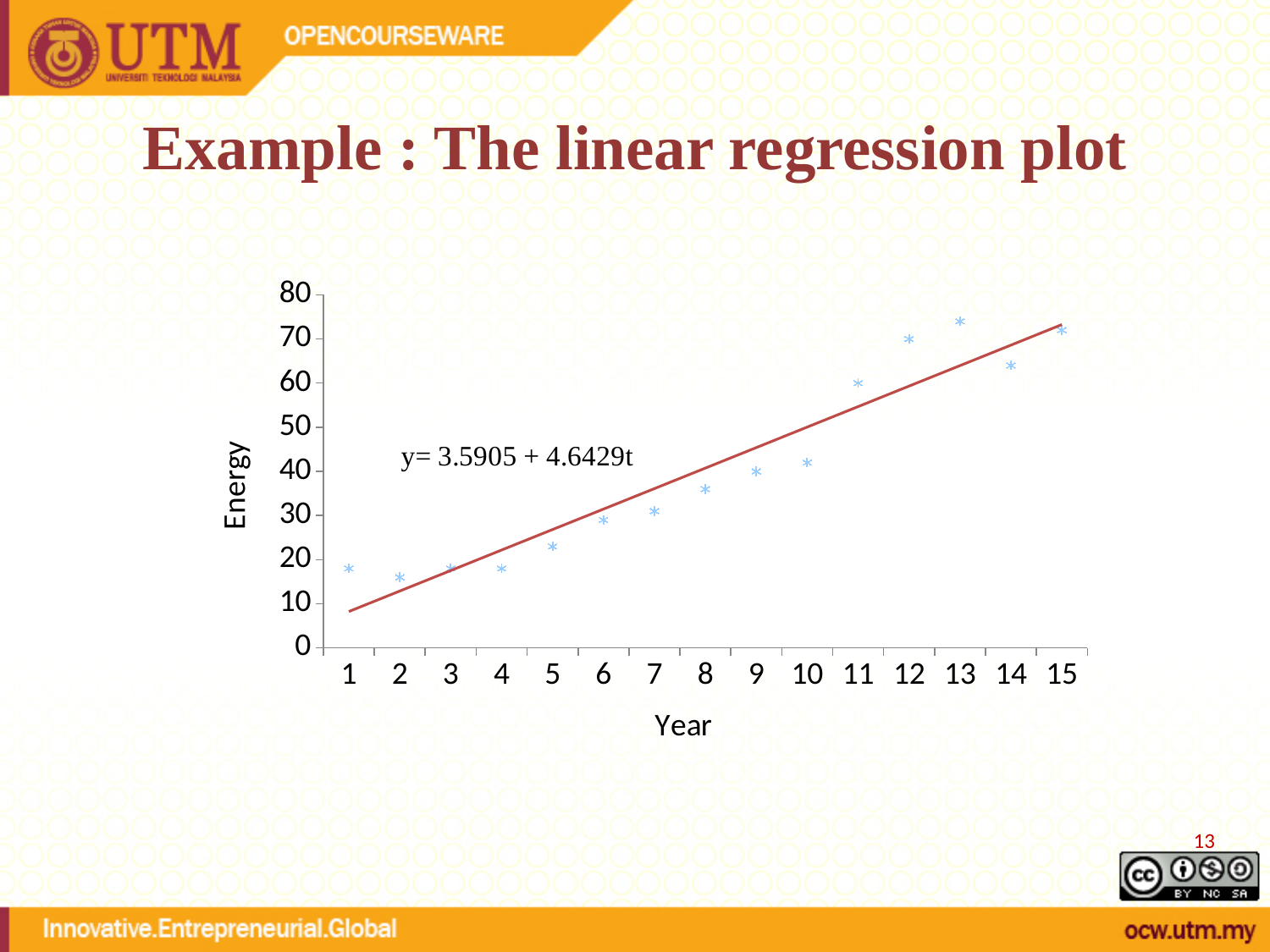
Is the Energy value for Year 1 greater or less than 20? less Which has the larger Energy value, Year 3 or Year 9? Year 9 Do the Energy values generally rise or fall as Year increases? rise How many data points are plotted on the chart? 15 What is the label of the vertical axis? Energy What regression equation is printed on the chart? y= 3.5905 + 4.6429t Which has the larger Energy value, Year 5 or Year 12? Year 12 Is the Energy value for Year 13 greater or less than 70? greater Is the Energy value for Year 14 greater or less than 60? greater What kind of chart is shown on the slide? scatter plot